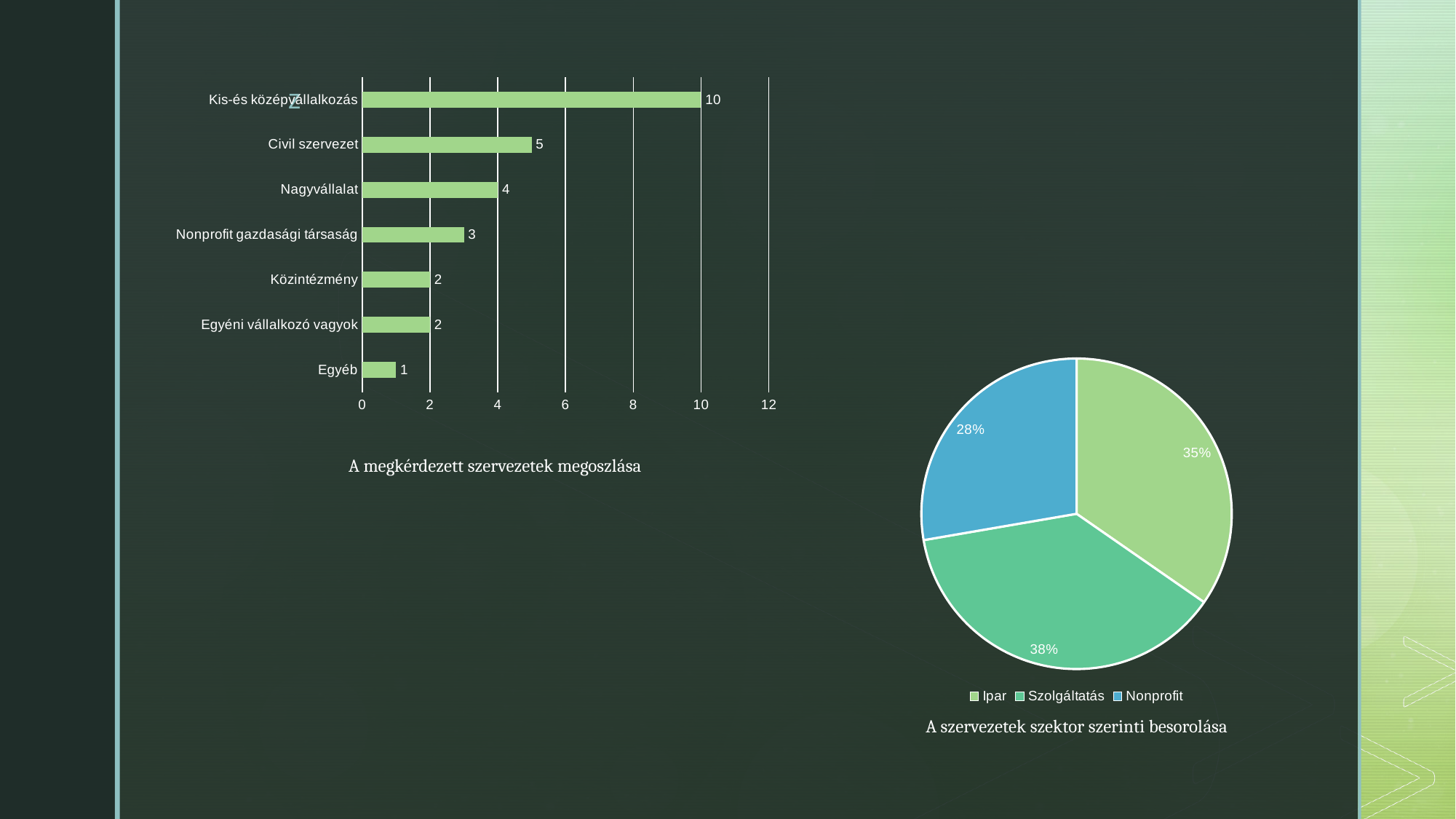
In the pie chart 'A szervezetek szektor szerinti besorolása', what share does Nonprofit have? 28% In the bar chart 'A megkérdezett szervezetek megoszlása', which category has the highest value? Kis-és középvállalkozás In the pie chart 'A szervezetek szektor szerinti besorolása', which sector has the largest share? Szolgáltatás In the pie chart 'A szervezetek szektor szerinti besorolása', what share does Szolgáltatás have? 38% What kind of chart is 'A megkérdezett szervezetek megoszlása'? Bar chart In the bar chart 'A megkérdezett szervezetek megoszlása', which is larger: Nagyvállalat or Közintézmény? Nagyvállalat How many categories does the bar chart 'A megkérdezett szervezetek megoszlása' show? 7 How many entries does the legend of the pie chart 'A szervezetek szektor szerinti besorolása' list? 3 In the bar chart 'A megkérdezett szervezetek megoszlása', what is the value for Kis-és középvállalkozás? 10 In the bar chart 'A megkérdezett szervezetek megoszlása', which category has the lowest value? Egyéb In the bar chart 'A megkérdezett szervezetek megoszlása', what is the value for Nonprofit gazdasági társaság? 3 In the bar chart 'A megkérdezett szervezetek megoszlása', what is the difference between the values for Kis-és középvállalkozás and Civil szervezet? 5